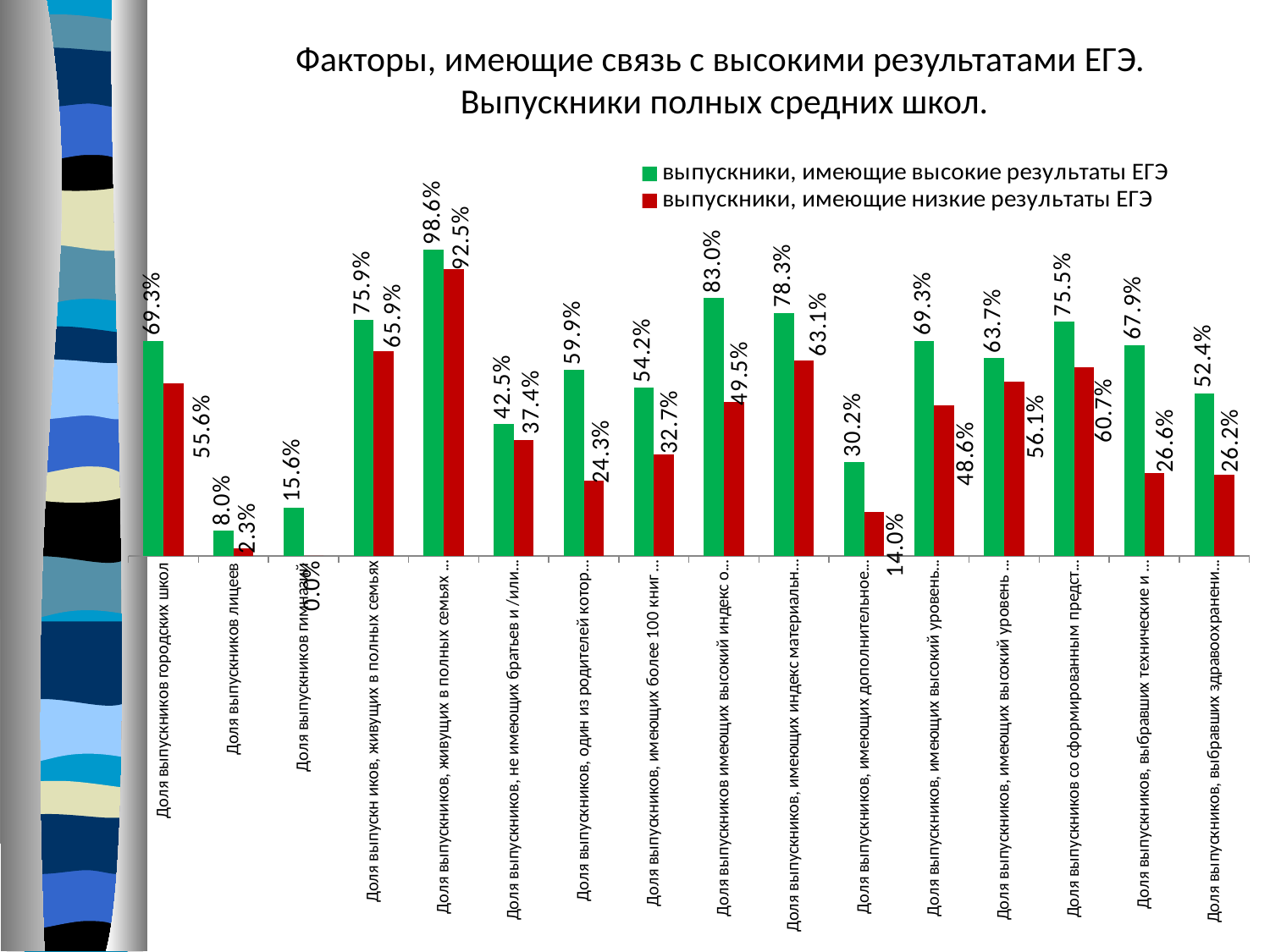
Which category has the lowest value in the series 'выпускники, имеющие низкие результаты ЕГЭ'? Доля выпускников гимназий What is the highest value shown in the series 'выпускники, имеющие высокие результаты ЕГЭ'? 98.6% What is the difference between the two series for 'Доля выпускников, имеющих более 100 книг...'? 21.5% What is the value for 'Доля выпускников, имеющих дополнительное...' in the series 'выпускники, имеющие высокие результаты ЕГЭ'? 30.2% What type of chart is shown on the slide? bar chart For 'Доля выпускников, один из родителей котор...', which series has the larger value? выпускники, имеющие высокие результаты ЕГЭ What is the difference between the two series for 'Доля выпускников, выбравших технические и...'? 41.3% What is the value for 'Доля выпускников лицеев' in the series 'выпускники, имеющие низкие результаты ЕГЭ'? 2.3% How many categories are plotted on the chart? 16 How many series does the legend list? 2 What is the value for 'Доля выпускников городских школ' in the series 'выпускники, имеющие высокие результаты ЕГЭ'? 69.3% Which colour represents the series 'выпускники, имеющие низкие результаты ЕГЭ'? red